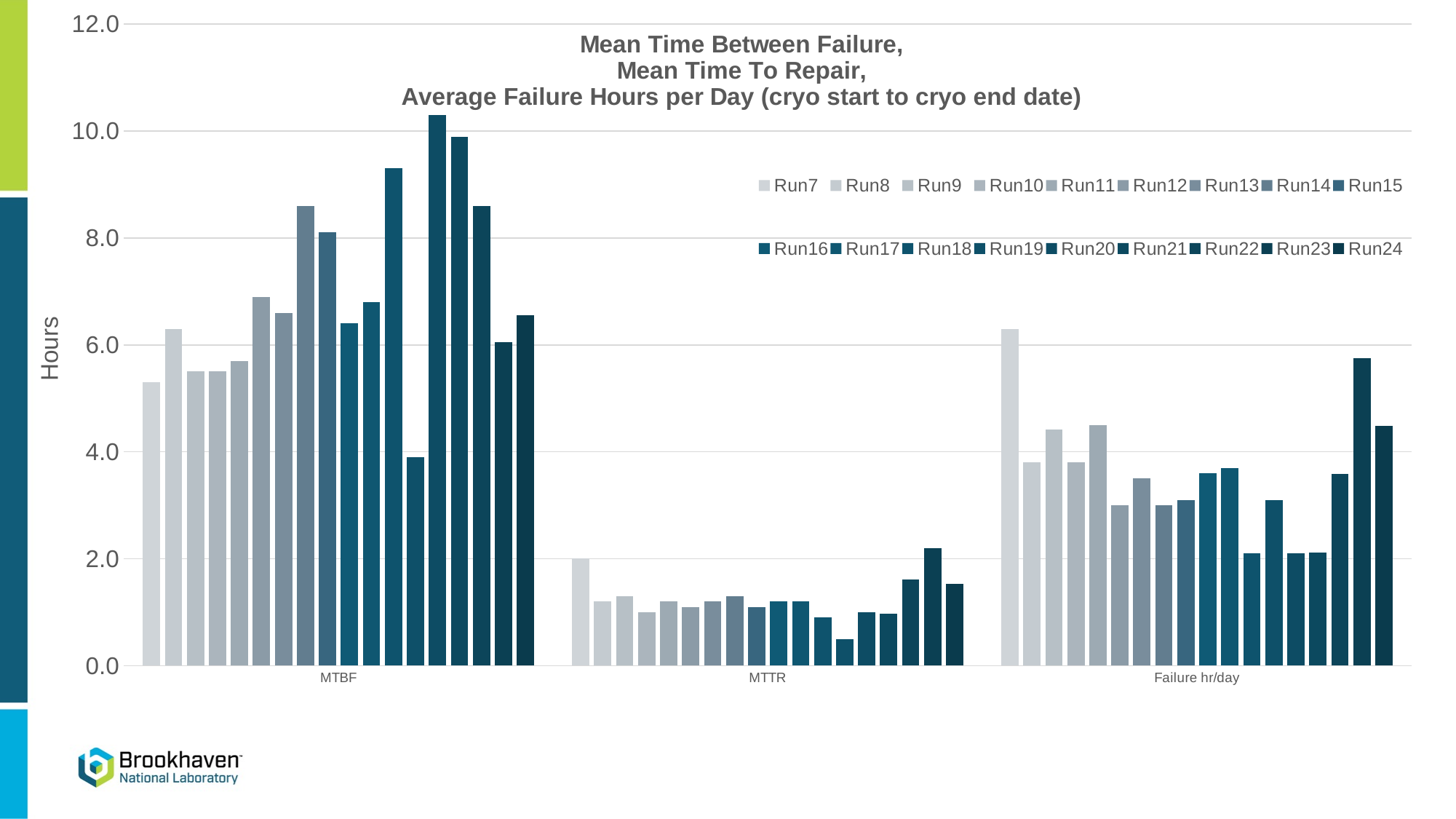
How many categories are shown along the x axis? 3 Which run has the highest MTBF value? Run20 Which run has the highest Failure hr/day value? Run7 What is the label on the vertical axis? Hours Which run has the lowest MTTR value? Run19 Which run has the lowest MTBF value? Run19 Which is larger, the MTBF value for Run20 or the MTBF value for Run19? Run20 Is the MTBF value for Run20 greater or less than 10.0? greater Is the Failure hr/day value for Run7 greater or less than 6.0? greater How many series does the legend list? 18 What kind of chart is shown on the slide? bar chart